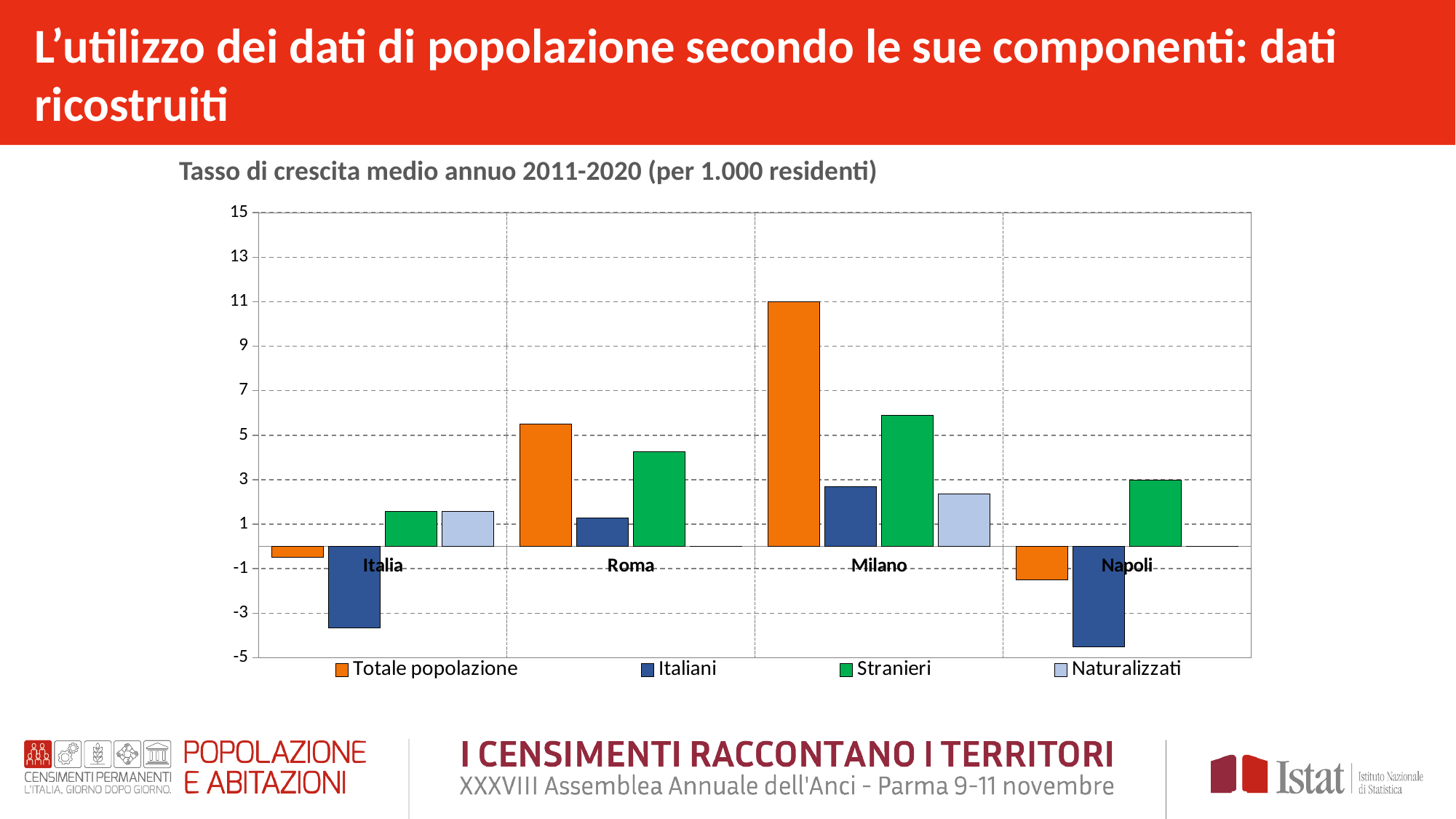
Is the Italiani value for Italia greater or less than -3? less Which is larger: the Stranieri value for Milano or the Stranieri value for Roma? Milano What is the title of the chart? Tasso di crescita medio annuo 2011-2020 (per 1.000 residenti) How many territorial categories are shown on the x axis? 4 What kind of chart is shown on the slide? bar chart Is the Totale popolazione value for Roma greater or less than 5? greater Which category has the lowest value for Italiani? Napoli Is the Totale popolazione value for Milano greater or less than 9? greater How many series does the legend list? 4 For Roma, which is larger: the value for Stranieri or the value for Italiani? Stranieri Which category has the highest value for Totale popolazione? Milano